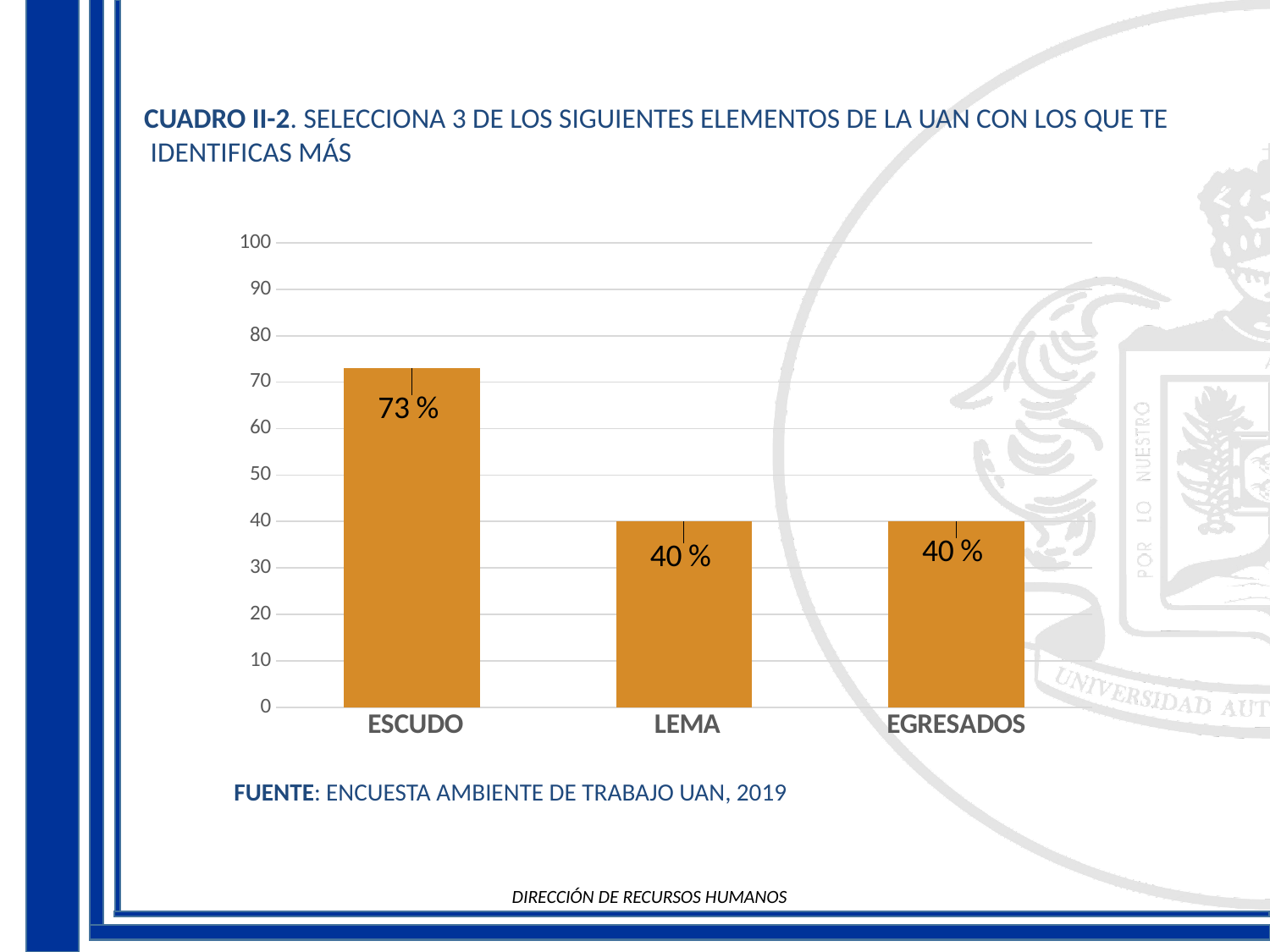
Which is larger, the value for ESCUDO or the value for EGRESADOS? ESCUDO What kind of chart is shown on the slide? bar chart What is the value for EGRESADOS? 40 % Is the value for ESCUDO greater or less than 70? greater What is the source cited below the chart? ENCUESTA AMBIENTE DE TRABAJO UAN, 2019 What is the highest value shown on the y axis? 100 Is the value for LEMA greater or less than 50? less What is the value for LEMA? 40 % What is the difference between the values for ESCUDO and LEMA? 33 % What is the value for ESCUDO? 73 % Which category has the highest value? ESCUDO How many categories are shown on the x axis? 3